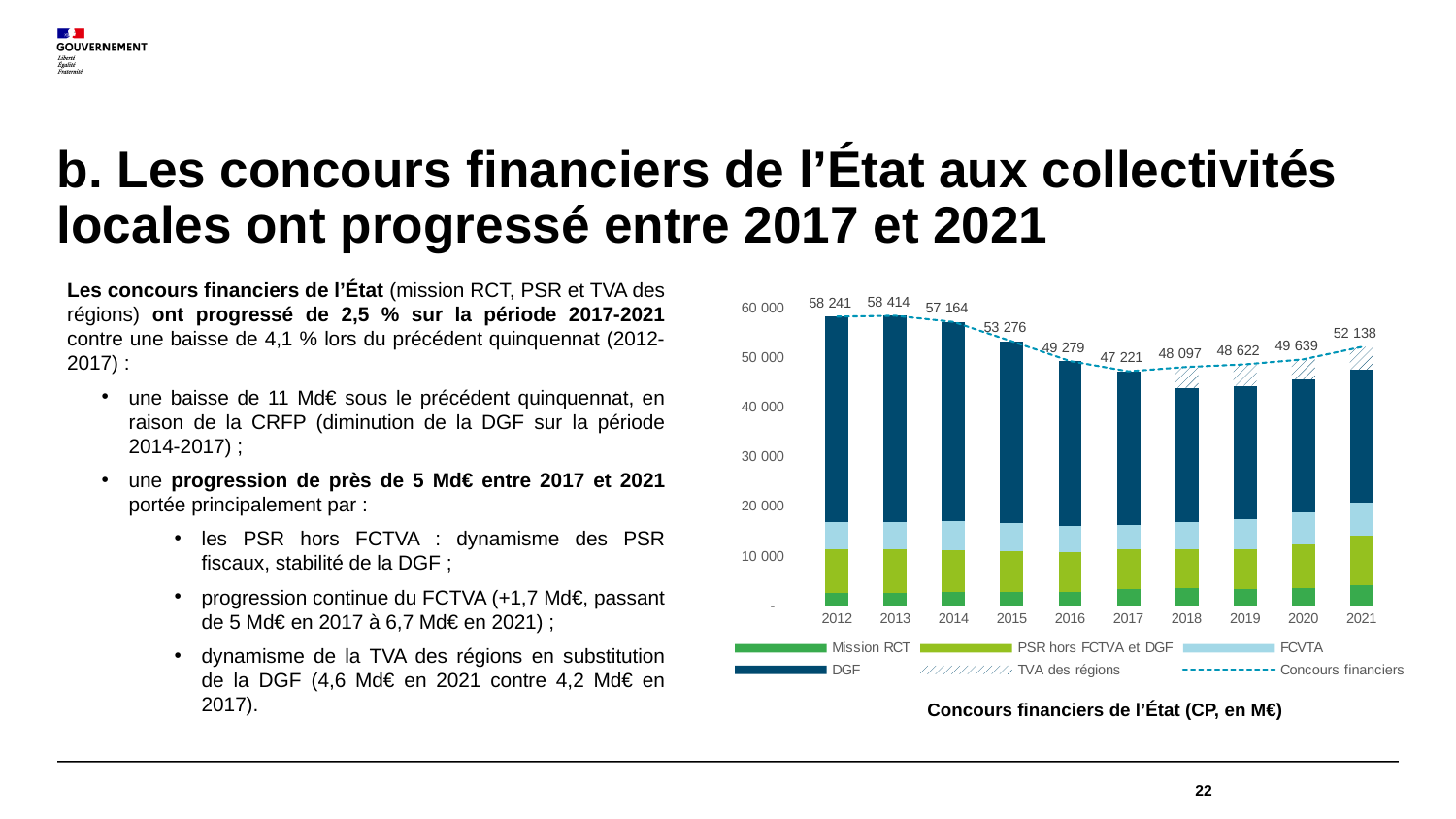
How many series does the chart legend list? 6 Which year has a larger Concours financiers value, 2015 or 2020? 2015 Does the Concours financiers value rise or fall from 2017 to 2021? rise What is the value of Concours financiers for 2019? 48 622 How many years are shown on the x axis of the chart? 10 What is the value of Concours financiers for 2021? 52 138 What is the value of Concours financiers for 2017? 47 221 What is the value of Concours financiers for 2012? 58 241 What is the difference between the Concours financiers values for 2021 and 2017? 4 917 Is the total height of the stacked bar for 2017 greater or less than 40 000? greater In which year is the Concours financiers value the highest? 2013 In which year is the Concours financiers value the lowest? 2017